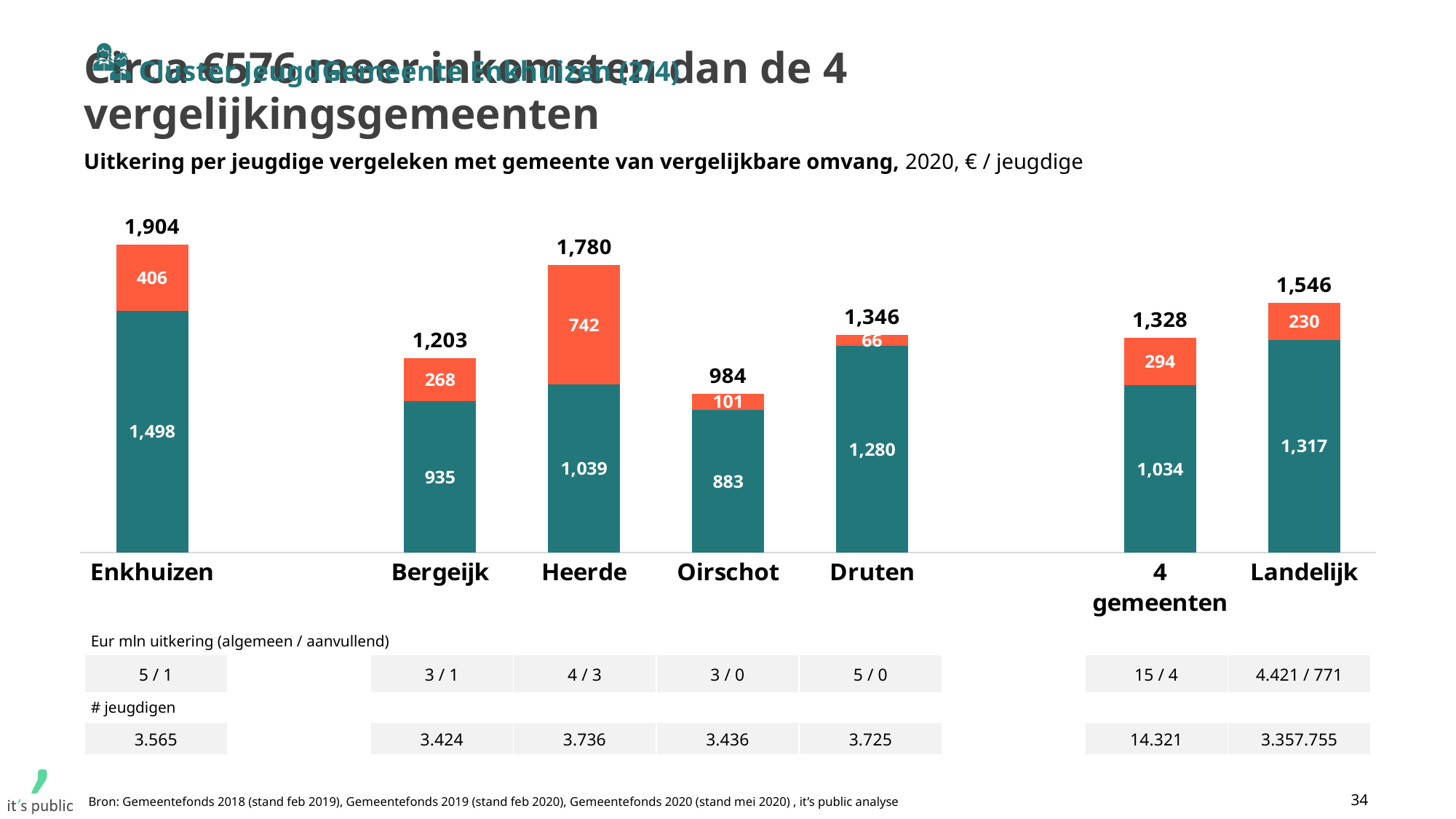
How many categories are shown on the x axis of the chart? 7 What is the value of the orange (upper) segment for Bergeijk? 268 What kind of chart is shown on the slide? Stacked bar chart What is the difference between the teal (lower) segment for Landelijk and the teal segment for Oirschot? 434 Which has a larger orange (upper) segment, Heerde or Druten? Heerde Which category has the highest total value? Enkhuizen What is the total value shown above the bar for Enkhuizen? 1,904 What is the value of the teal (lower) segment for Heerde? 1,039 What is the total value shown above the bar for Landelijk? 1,546 What is the sum of the two segments of the Druten bar? 1,346 What is the difference between the total for Enkhuizen and the total for 4 gemeenten? 576 Which category has the lowest total value? Oirschot